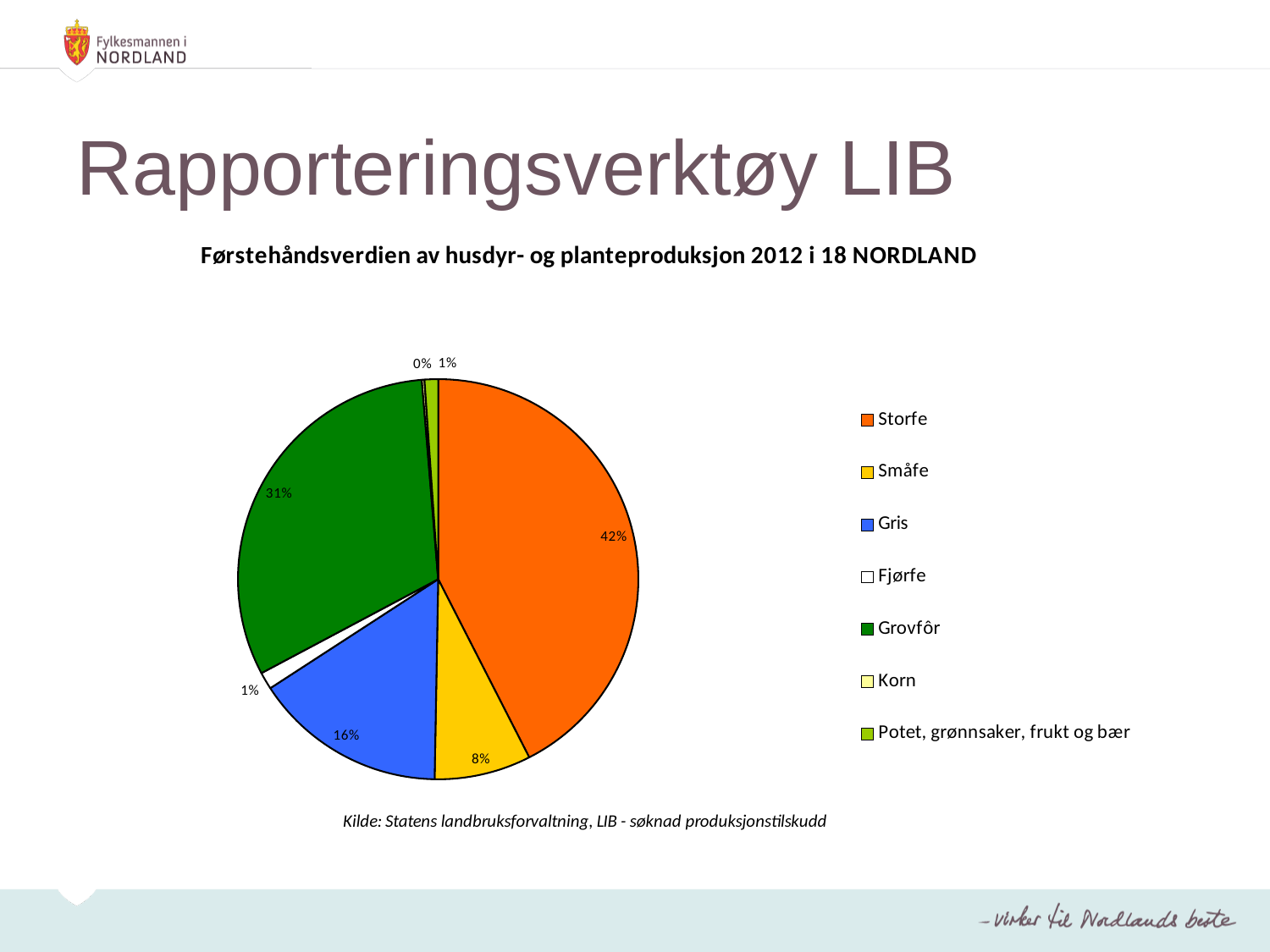
What share of the pie does Storfe represent? 42% Which category has the largest share of the pie? Storfe What share of the pie does Gris represent? 16% What share of the pie does Småfe represent? 8% How many entries does the legend list? 7 What is the difference in percentage points between the shares of Storfe and Grovfôr? 11 What kind of chart is shown on the slide? pie chart Which category has the smallest share of the pie? Korn What is the title of the chart? Førstehåndsverdien av husdyr- og planteproduksjon 2012 i 18 NORDLAND Which has the larger share, Gris or Småfe? Gris